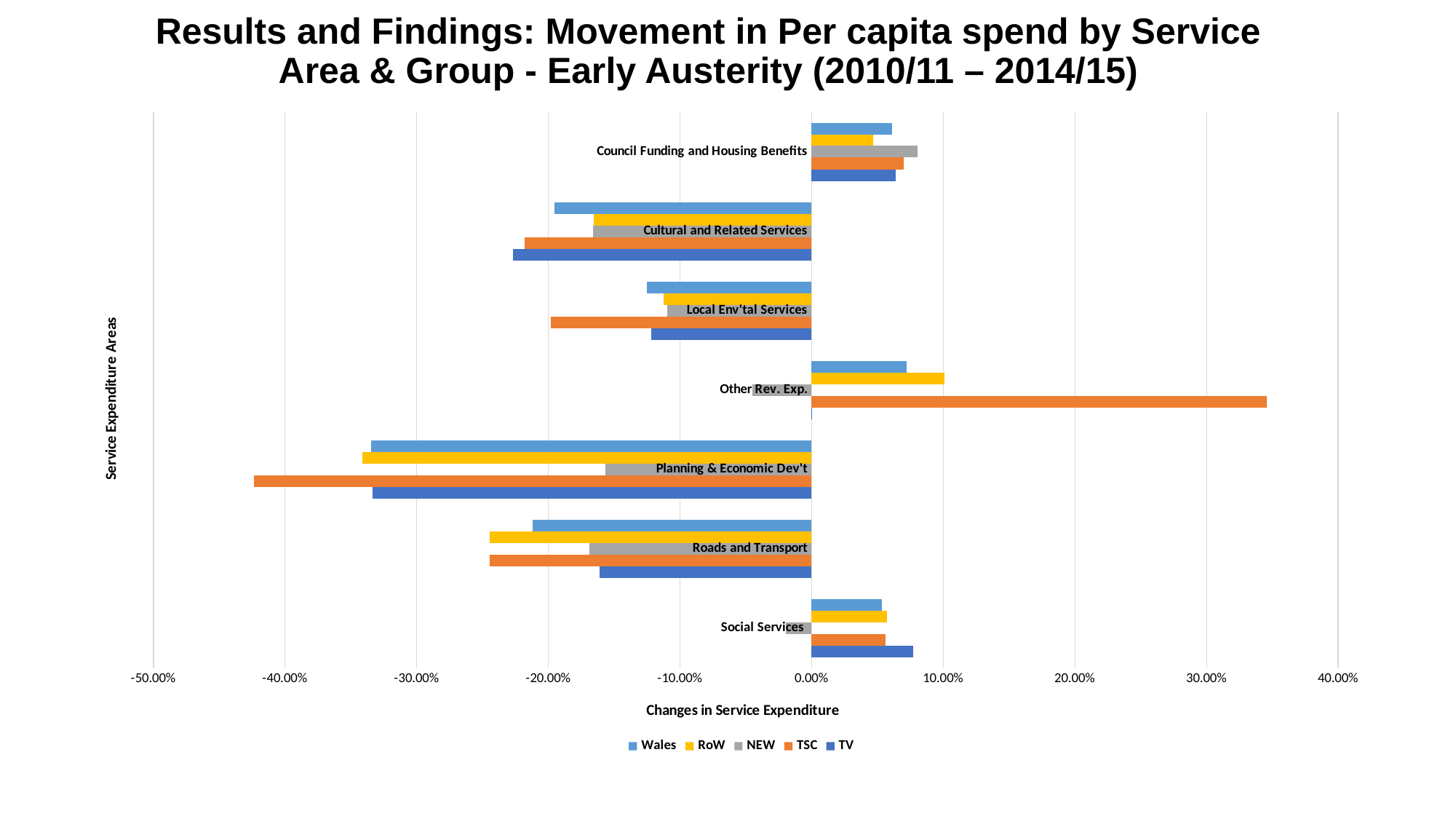
Is the TSC value for Local Env'tal Services greater or less than -10.00%? less Which service expenditure area has the lowest Wales value? Planning & Economic Dev't For Roads and Transport, which is larger: the Wales value or the NEW value? NEW How many service expenditure areas (categories) are plotted on the chart? 7 Is the TSC value for Planning & Economic Dev't greater or less than -40.00%? less Which series has the highest value for Other Rev. Exp.? TSC Is the TSC value for Other Rev. Exp. greater or less than 30.00%? greater Which series has the lowest value for Planning & Economic Dev't? TSC What is the title of the horizontal axis? Changes in Service Expenditure How many series does the legend list? 5 What kind of chart is shown on the slide? Bar chart